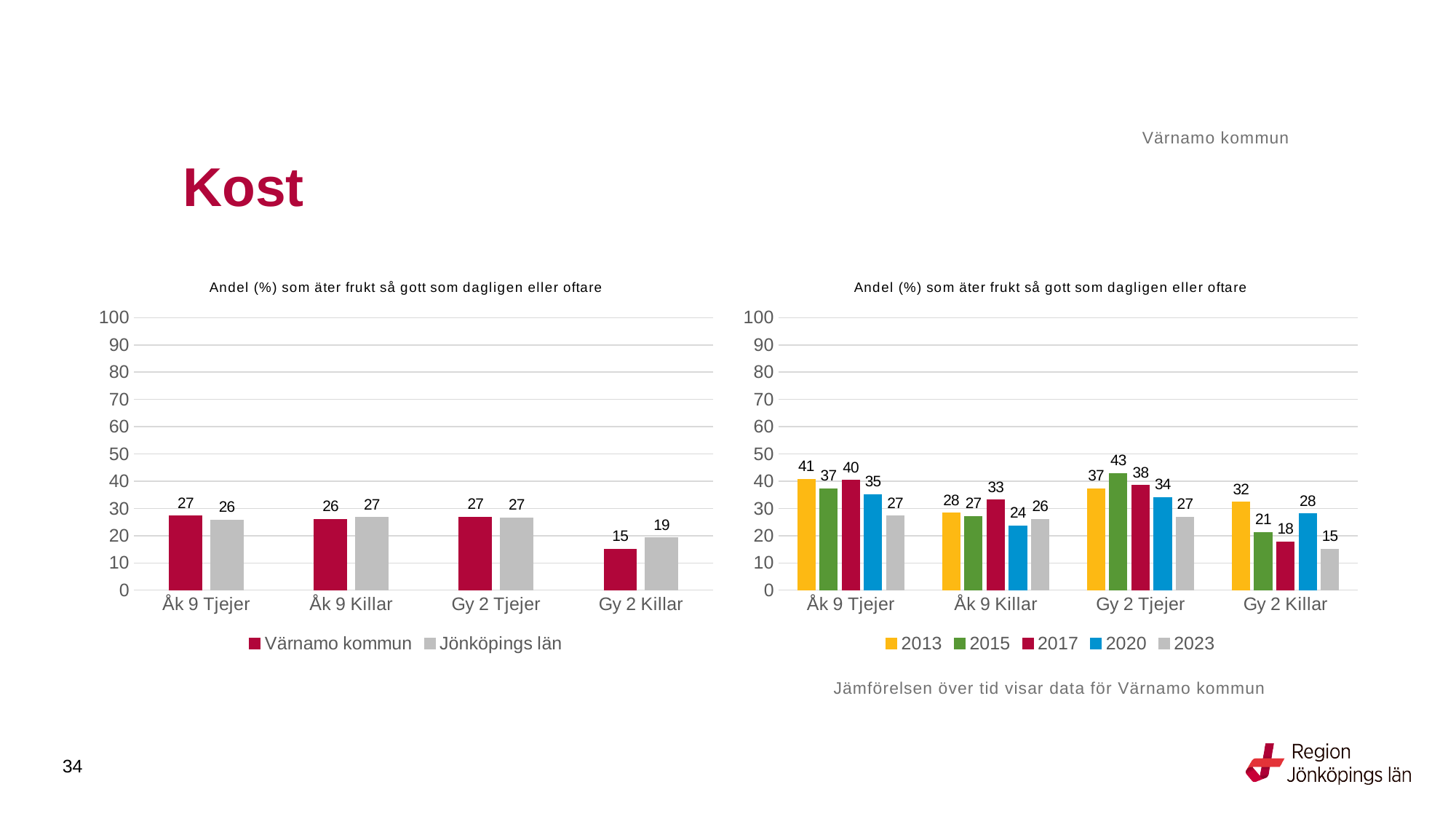
In the left chart, what is the value for Värnamo kommun for Gy 2 Killar? 15 In the left chart, what is the difference between Jönköpings län and Värnamo kommun for Gy 2 Killar? 4 In the right chart, which year has the lowest value for Gy 2 Killar? 2023 What kind of chart is the right chart? Bar chart In the right chart, what is the difference between the 2013 and 2023 values for Åk 9 Tjejer? 14 In the right chart, how many series does the legend list? 5 In the right chart, what is the value for 2023 for Åk 9 Killar? 26 In the left chart, how many series does the legend list? 2 In the right chart, what is the value for 2015 for Gy 2 Tjejer? 43 In the left chart, which category has the lowest value for Värnamo kommun? Gy 2 Killar In the left chart, what is the value for Jönköpings län for Gy 2 Killar? 19 In the right chart, which year has the highest value for Åk 9 Tjejer? 2013